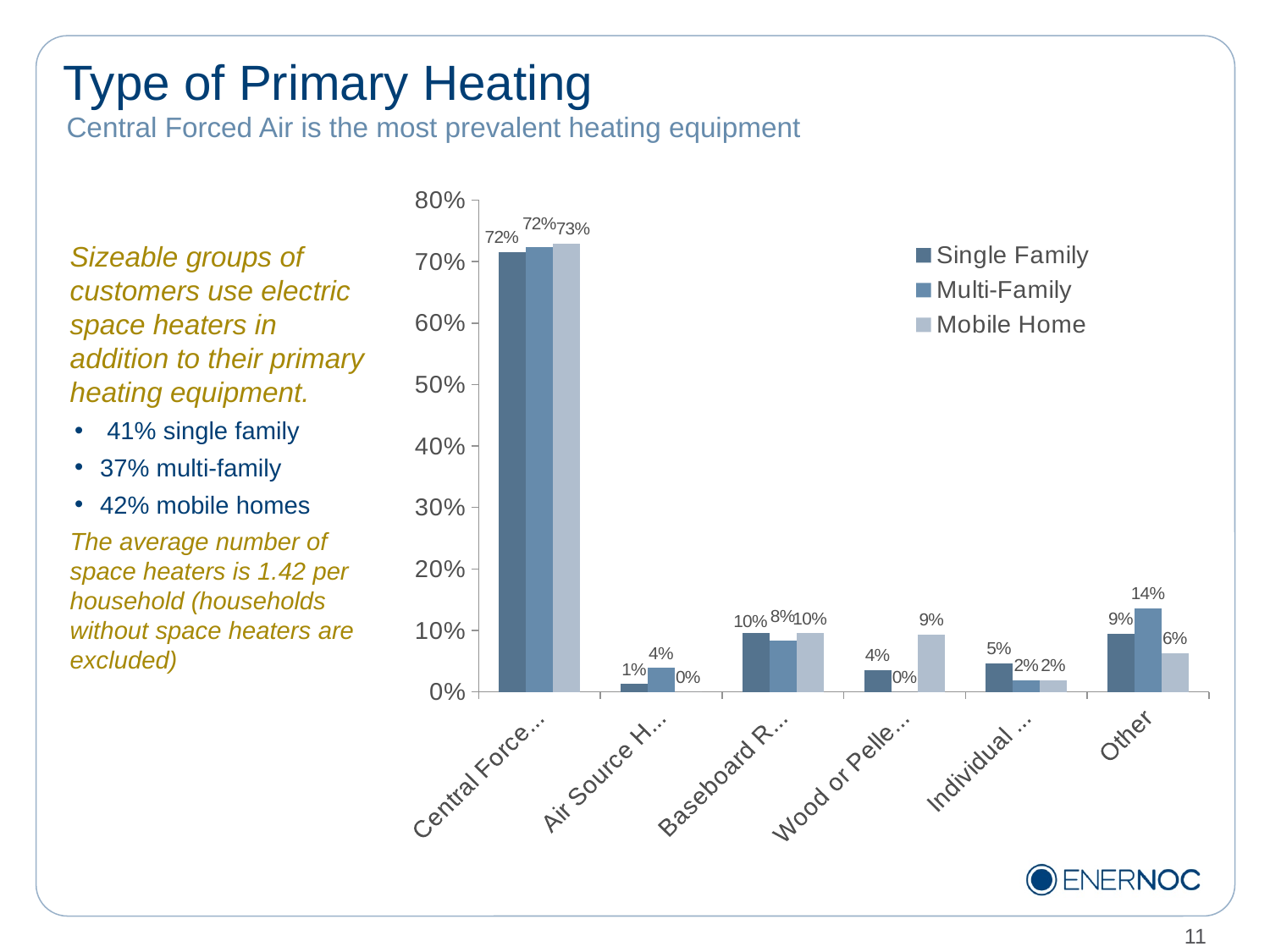
In the 'Other' category, which is larger: the Single Family value or the Mobile Home value? Single Family What is the difference between the Multi-Family and Mobile Home values in the 'Other' category? 8% What is the Mobile Home value for the category labelled 'Wood or Pelle...'? 9% How many heating-type categories are shown along the x axis? 6 Which category has the highest values for all three series? Central Force... What are the three series named in the legend? Single Family, Multi-Family, Mobile Home What kind of chart is shown on the slide? bar chart Which series has the highest value in the 'Other' category? Multi-Family What is the Multi-Family value for the 'Other' category? 14% How many series does the legend list? 3 What is the Mobile Home value for the 'Other' category? 6% Is the Single Family value for the category labelled 'Central Force...' greater or less than 60%? greater